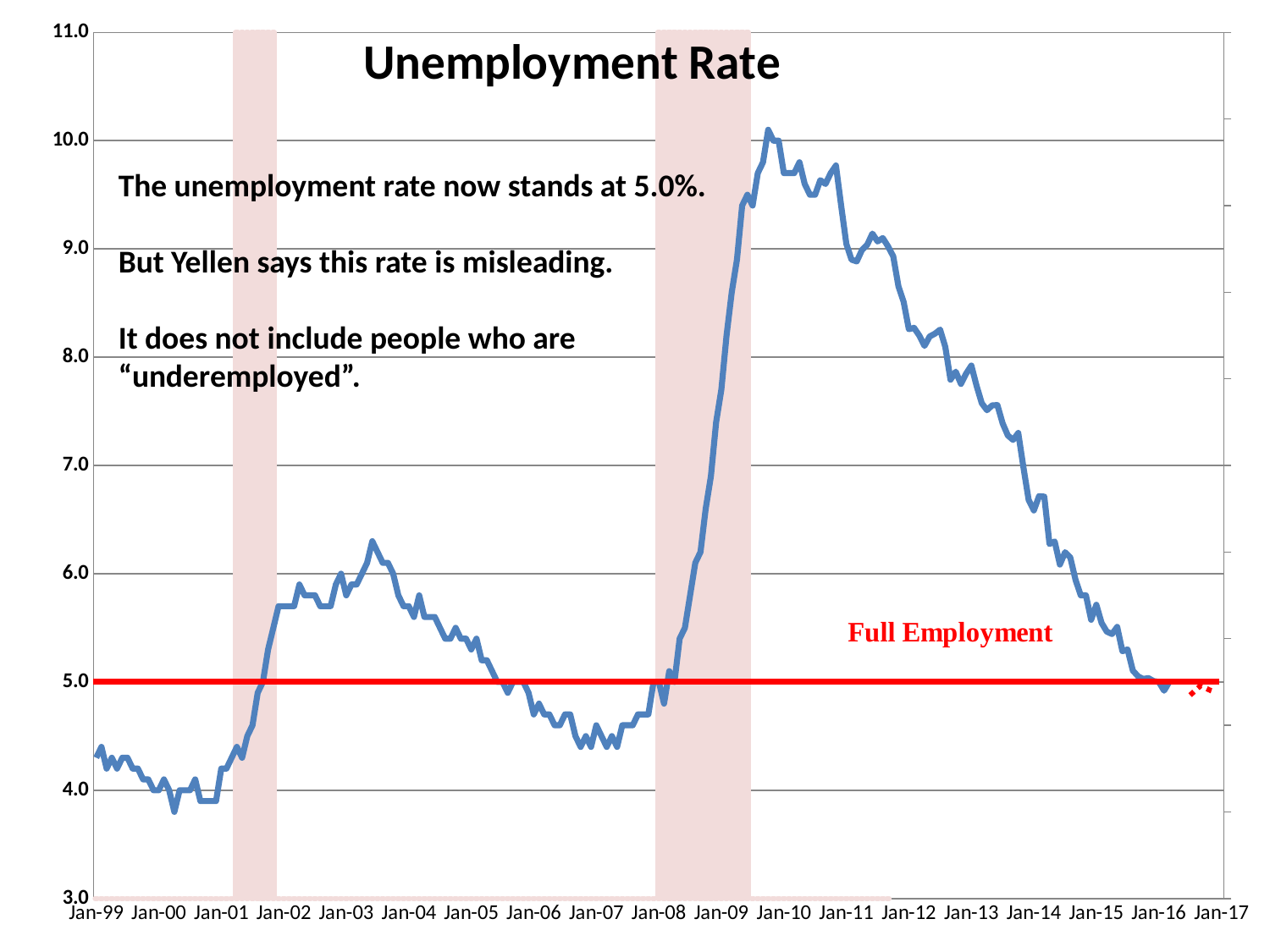
Which of the labeled dates on the x axis has the highest unemployment rate? Jan-10 Is the unemployment rate at Jan-99 greater or less than 5.0? less According to the slide text, what does the unemployment rate now stand at? 5.0% At what level on the y axis is the red 'Full Employment' line drawn? 5.0 Which is larger, the unemployment rate at Jan-03 or at Jan-10? Jan-10 How many date labels are shown on the x axis? 19 What is the title of the chart? Unemployment Rate Does the unemployment rate rise or fall between Jan-10 and Jan-16? fall Is the unemployment rate at Jan-10 greater or less than 9.0? greater Is the unemployment rate at Jan-07 greater or less than 5.0? less What kind of chart is shown on the slide? line chart